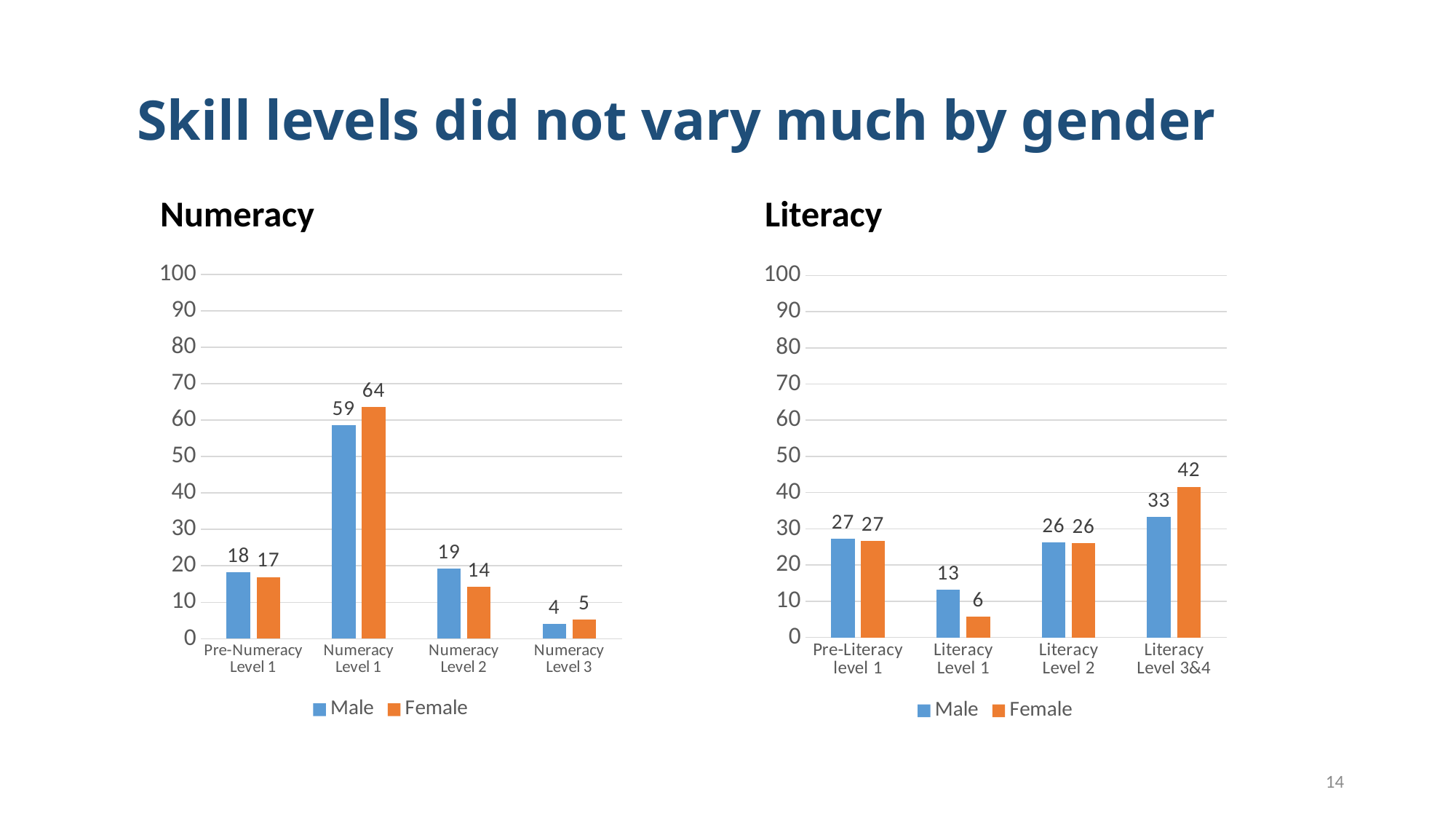
In the Literacy chart, what is the Male value for Literacy Level 3&4? 33 In the Literacy chart, what is the difference between the Female and Male values for Literacy Level 3&4? 9 In the Numeracy chart, what is the Male value for Numeracy Level 1? 59 In the Numeracy chart, which category has the highest Female value? Numeracy Level 1 What kind of chart is the Numeracy chart? Bar chart In the Literacy chart, what is the Female value for Literacy Level 1? 6 In the Numeracy chart, what is the difference between the Female and Male values for Numeracy Level 1? 5 In the Numeracy chart, what is the Female value for Numeracy Level 2? 14 How many series does the legend of the Numeracy chart list? 2 How many categories are shown on the x axis of the Literacy chart? 4 In the Literacy chart, which category has the lowest Male value? Literacy Level 1 In the Literacy chart, which is larger for Literacy Level 1, the Male value or the Female value? Male